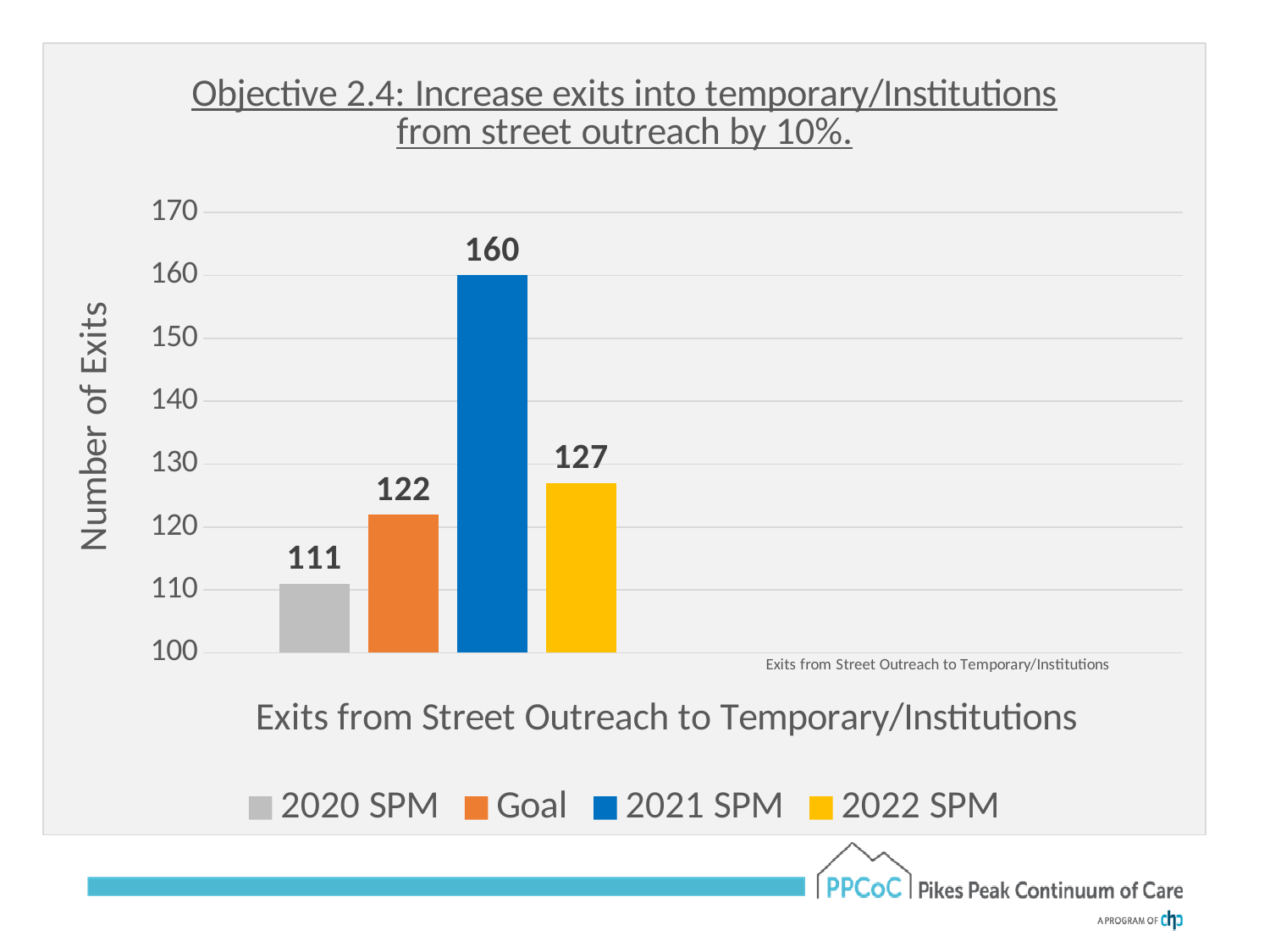
What is the label of the vertical axis? Number of Exits What kind of chart is shown on the slide? Bar chart How many series does the legend list? 4 What is the value for 2020 SPM? 111 Which series has the lowest value? 2020 SPM What is the difference between the 2021 SPM value and the 2022 SPM value? 33 What is the value for 2022 SPM? 127 What is the difference between the 2022 SPM value and the Goal value? 5 What is the value for 2021 SPM? 160 What is the value for the Goal series? 122 Which series has the highest value? 2021 SPM Which is larger, the 2022 SPM value or the Goal value? 2022 SPM